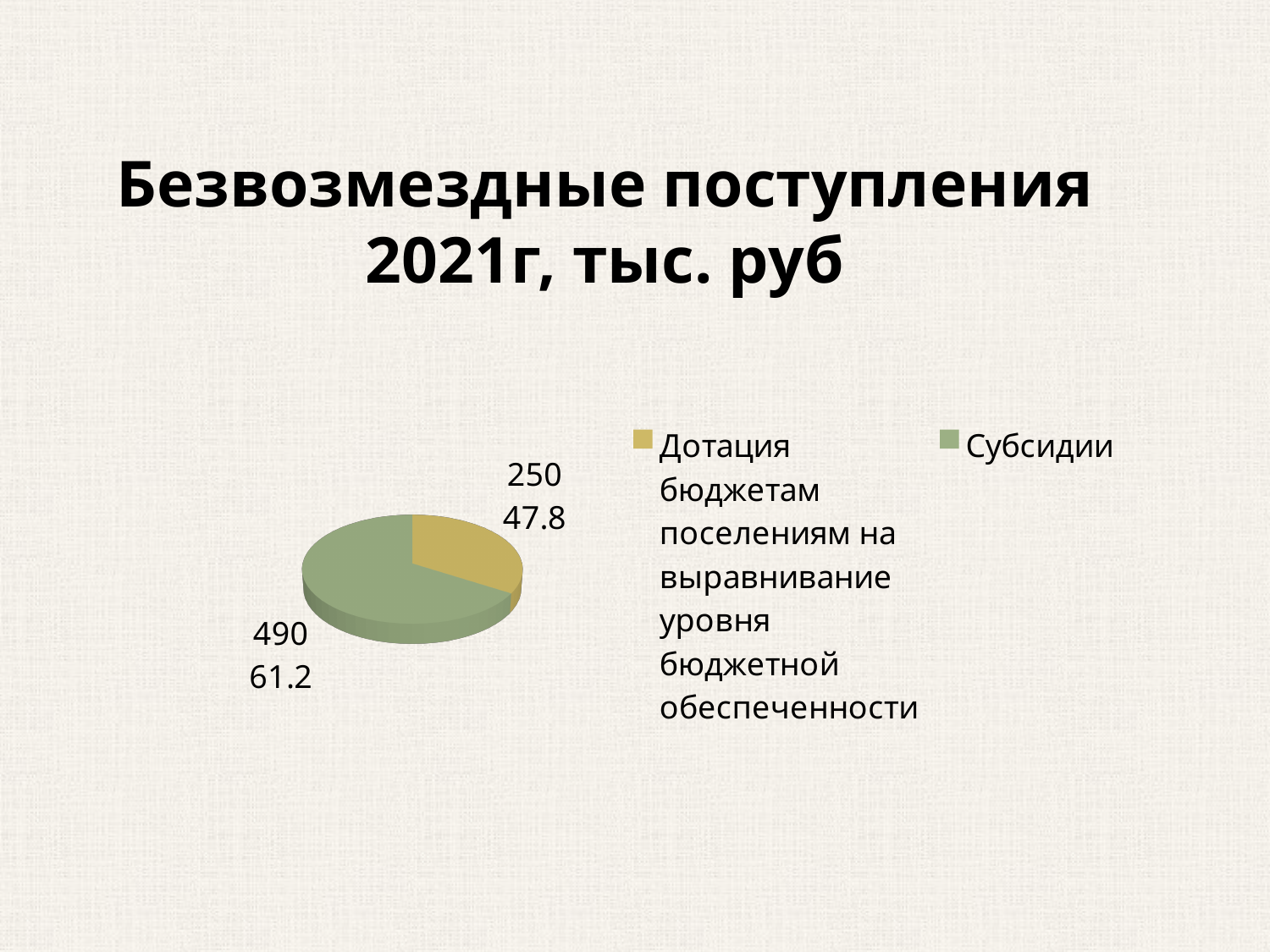
Which is larger: the value for Субсидии or the value for Дотация бюджетам поселениям на выравнивание уровня бюджетной обеспеченности? Субсидии What value is printed for the Субсидии slice? 49061.2 What is the title of the chart on the slide? Безвозмездные поступления 2021г, тыс. руб What colour is the Субсидии slice? green Which slice of the pie is the largest? Субсидии What is the difference between the value for Субсидии and the value for Дотация бюджетам поселениям на выравнивание уровня бюджетной обеспеченности? 24013.4 How many entries does the legend list? 2 How many slices does the pie chart have? 2 What value is printed for the slice labelled Дотация бюджетам поселениям на выравнивание уровня бюджетной обеспеченности? 25047.8 What type of chart is shown on the slide? pie chart Which slice of the pie is the smallest? Дотация бюджетам поселениям на выравнивание уровня бюджетной обеспеченности